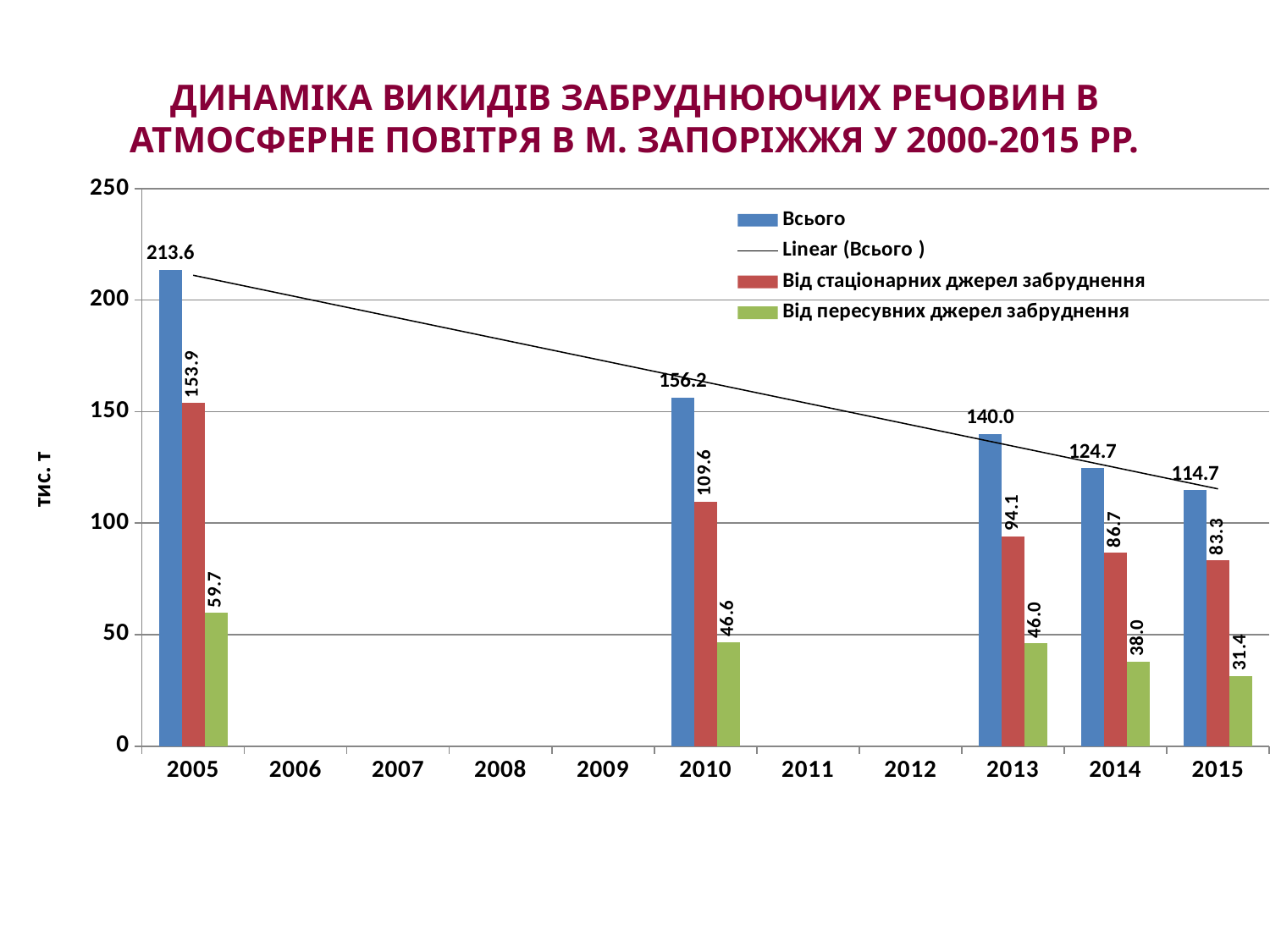
Is the value of "Всього" for 2010 greater or less than 150? greater What is the difference between the "Всього" values for 2005 and 2015? 98.9 Which year has the highest value for "Всього"? 2005 What is the value of "Всього" for 2005? 213.6 Which is larger: "Від стаціонарних джерел забруднення" in 2013 or in 2014? 2013 How many entries does the legend list? 4 How many years have bars plotted on the chart? 5 What kind of chart is shown on the slide? bar chart Which year has the lowest value for "Від пересувних джерел забруднення"? 2015 What is the value of "Від стаціонарних джерел забруднення" for 2010? 109.6 What is the value of "Від пересувних джерел забруднення" for 2014? 38.0 Do the "Всього" values rise or fall from 2005 to 2015? fall